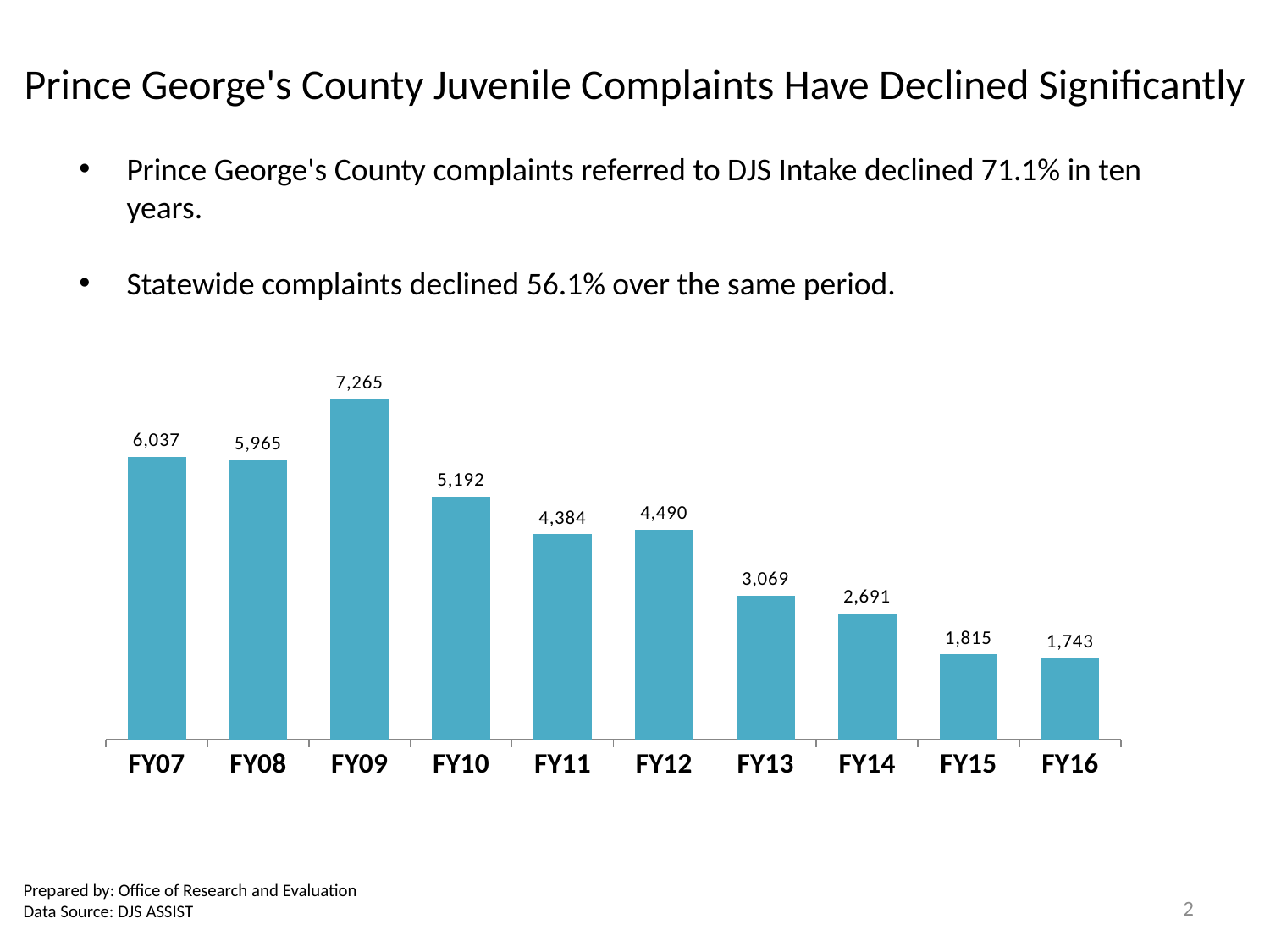
Do the values generally rise or fall from FY09 to FY16? Fall Which fiscal year has the highest value? FY09 What is the value for FY16? 1,743 Which is larger, the value for FY11 or the value for FY12? FY12 What is the difference between the values for FY09 and FY10? 2,073 What is the value for FY12? 4,490 Which fiscal year has the lowest value? FY16 What is the difference between the values for FY07 and FY16? 4,294 Which is larger, the value for FY13 or the value for FY14? FY13 What kind of chart is shown on the slide? Bar chart How many fiscal years are shown on the x axis? 10 What is the value for FY09? 7,265